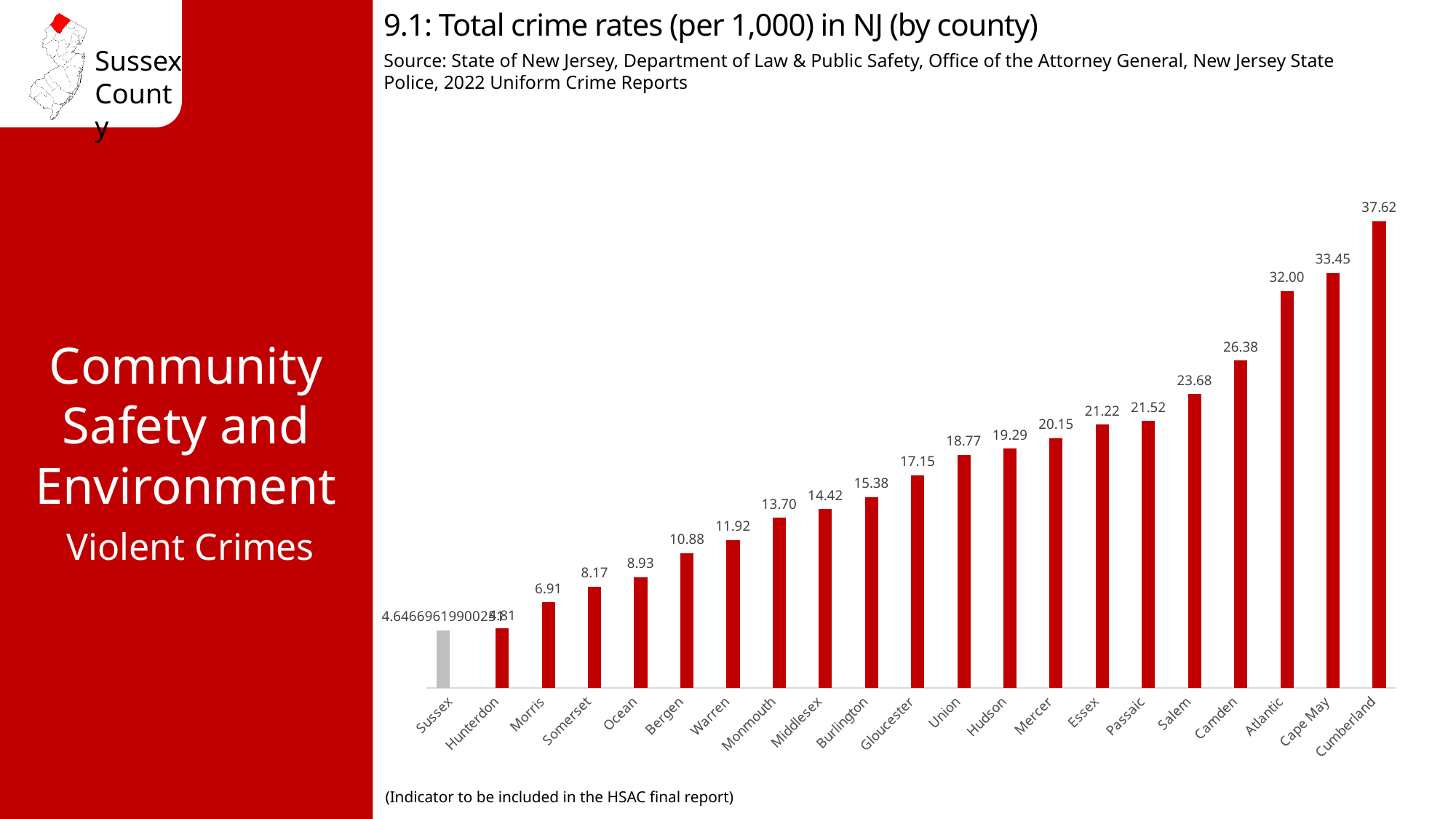
What is the difference between the crime rates of Atlantic and Camden? 5.62 What type of chart is shown on the slide? bar chart Which county has the highest total crime rate in the chart? Cumberland Do the values rise or fall moving from left to right along the x axis? rise Which county has a higher total crime rate, Salem or Camden? Camden What is the difference between the crime rates of Cumberland and Cape May? 4.17 What is the total crime rate (per 1,000) for Cumberland county? 37.62 What is the total crime rate (per 1,000) for Union county? 18.77 What is the total crime rate (per 1,000) for Cape May county? 33.45 What is the total crime rate (per 1,000) for Morris county? 6.91 Which county's bar is coloured grey instead of red? Sussex How many counties are shown in the chart? 21